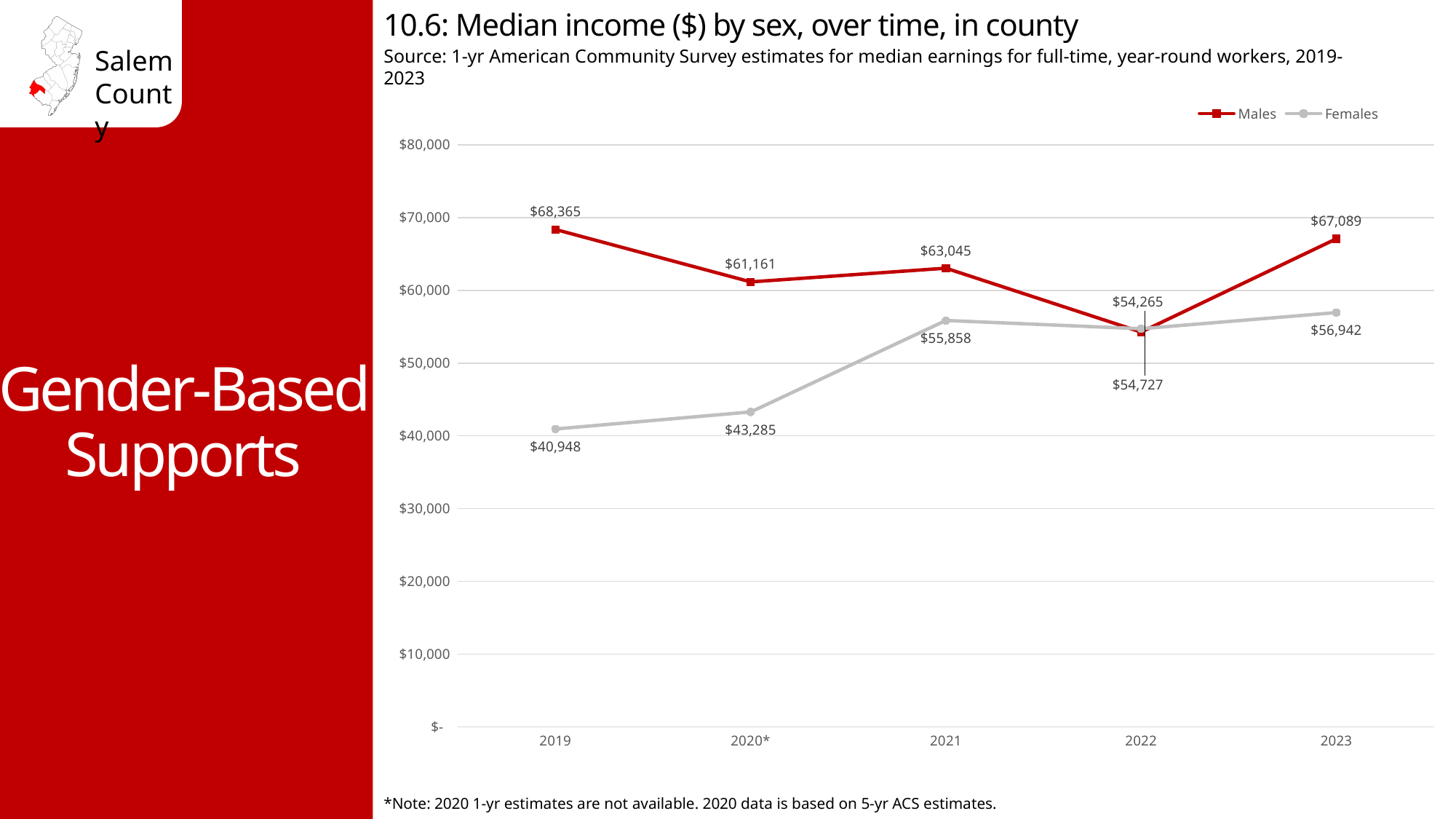
What was the median income for Females in 2021? $55,858 What was the median income for Males in 2023? $67,089 What is the difference between the Males and Females median income in 2019? $27,417 Which series had the higher median income in 2021, Males or Females? Males Is the Females median income in 2020* greater or less than $50,000? less In which year was the Females median income highest? 2023 What was the median income for Females in 2019? $40,948 In which year was the Males median income lowest? 2022 How many series does the legend list? 2 What was the median income for Males in 2019? $68,365 What kind of chart is shown on the slide? line chart How many years are shown on the x axis? 5